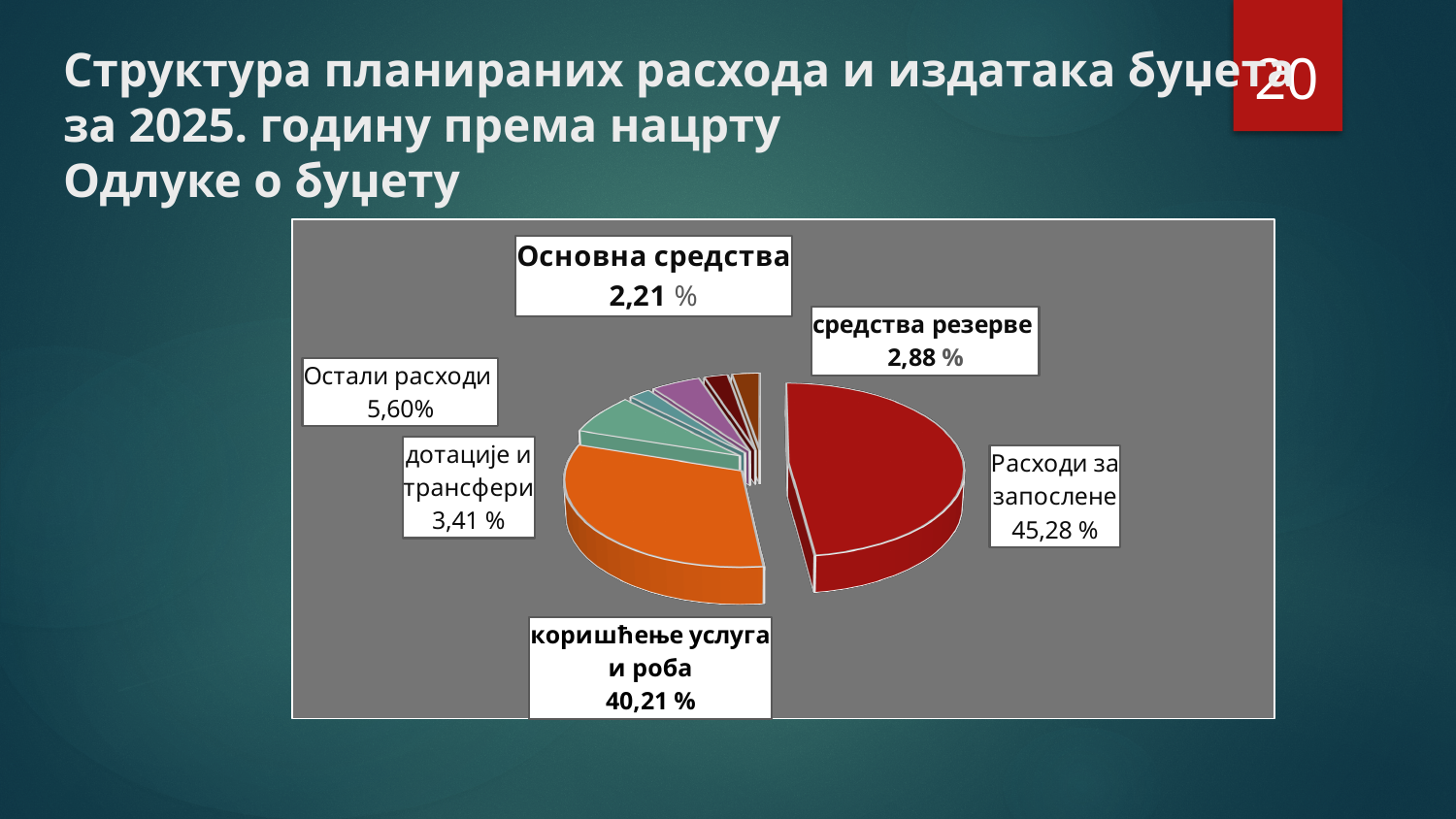
Which is larger: the share for Остали расходи or the share for дотације и трансфери? Остали расходи What share of the pie is labelled for Расходи за запослене? 45,28 % What share of the pie is labelled for Остали расходи? 5,60% Which labelled category has the smallest share of the pie? Основна средства Which labelled category has the largest share of the pie? Расходи за запослене What colour is the slice for Расходи за запослене? red What share of the pie is labelled for Основна средства? 2,21 % What share of the pie is labelled for дотације и трансфери? 3,41 % What kind of chart is shown on the slide? pie chart What share of the pie is labelled for коришћење услуга и роба? 40,21 % What share of the pie is labelled for средства резерве? 2,88 % What is the difference in percentage points between the shares for Расходи за запослене and коришћење услуга и роба? 5,07